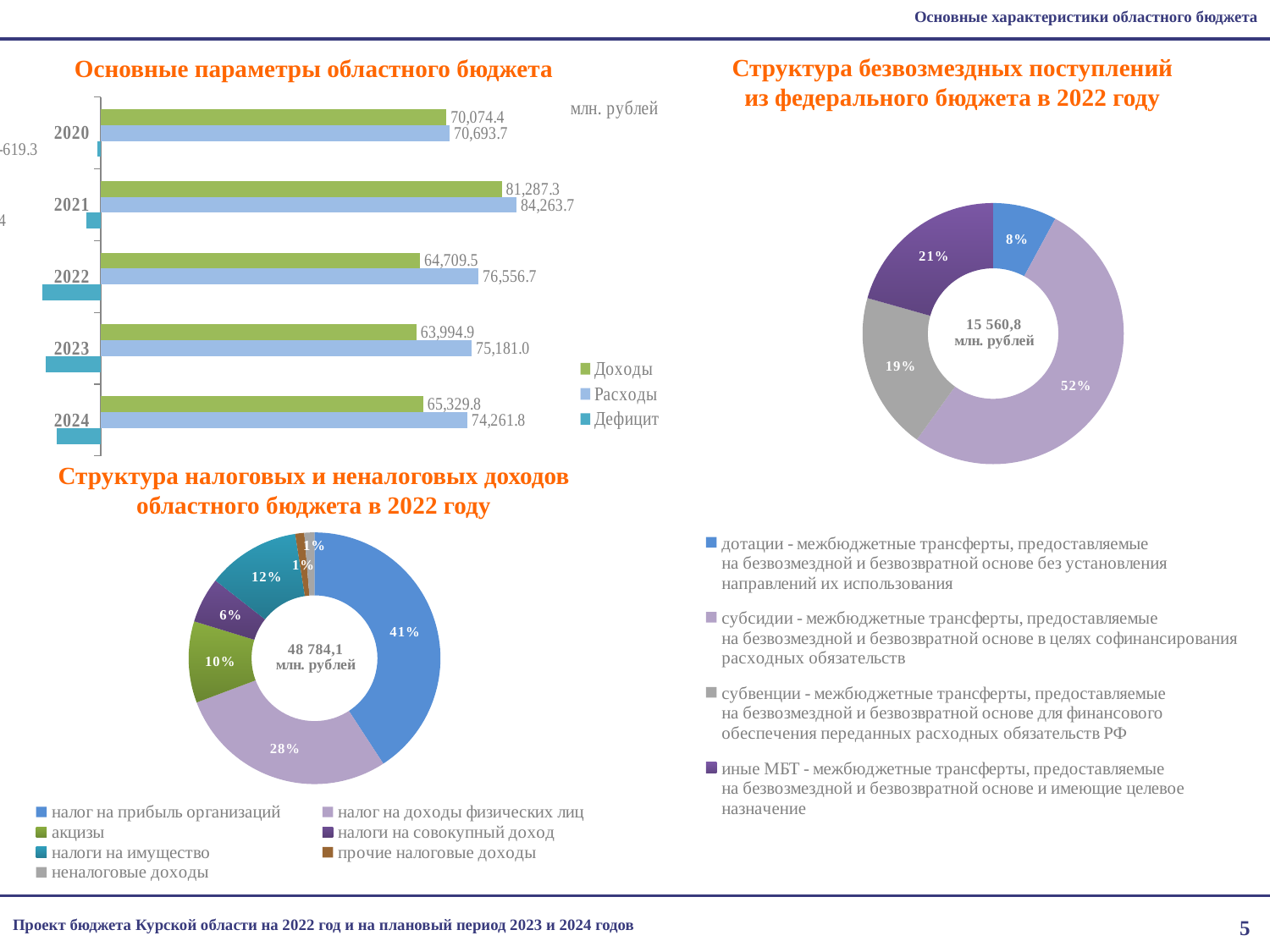
In the chart 'Основные параметры областного бюджета', how many series does the legend list? 3 In the chart 'Структура налоговых и неналоговых доходов областного бюджета в 2022 году', what total amount is shown in the centre of the donut? 48 784,1 млн. рублей In the chart 'Основные параметры областного бюджета', what is the difference between Расходы and Доходы for 2024? 8,932.0 In the chart 'Структура налоговых и неналоговых доходов областного бюджета в 2022 году', which category has the largest share? налог на прибыль организаций In the chart 'Основные параметры областного бюджета', which year has the highest Расходы value? 2021 In the chart 'Структура налоговых и неналоговых доходов областного бюджета в 2022 году', what share does налог на доходы физических лиц have? 28% What type of chart is 'Основные параметры областного бюджета'? bar chart In the chart 'Структура безвозмездных поступлений из федерального бюджета в 2022 году', what share do субсидии have? 52% In the chart 'Основные параметры областного бюджета', what is the value of Расходы for 2022? 76,556.7 In the chart 'Структура безвозмездных поступлений из федерального бюджета в 2022 году', which is larger: the share of субвенции or the share of иные МБТ? иные МБТ In the chart 'Основные параметры областного бюджета', which year has the lowest Доходы value? 2023 In the chart 'Основные параметры областного бюджета', what is the value of Доходы for 2021? 81,287.3